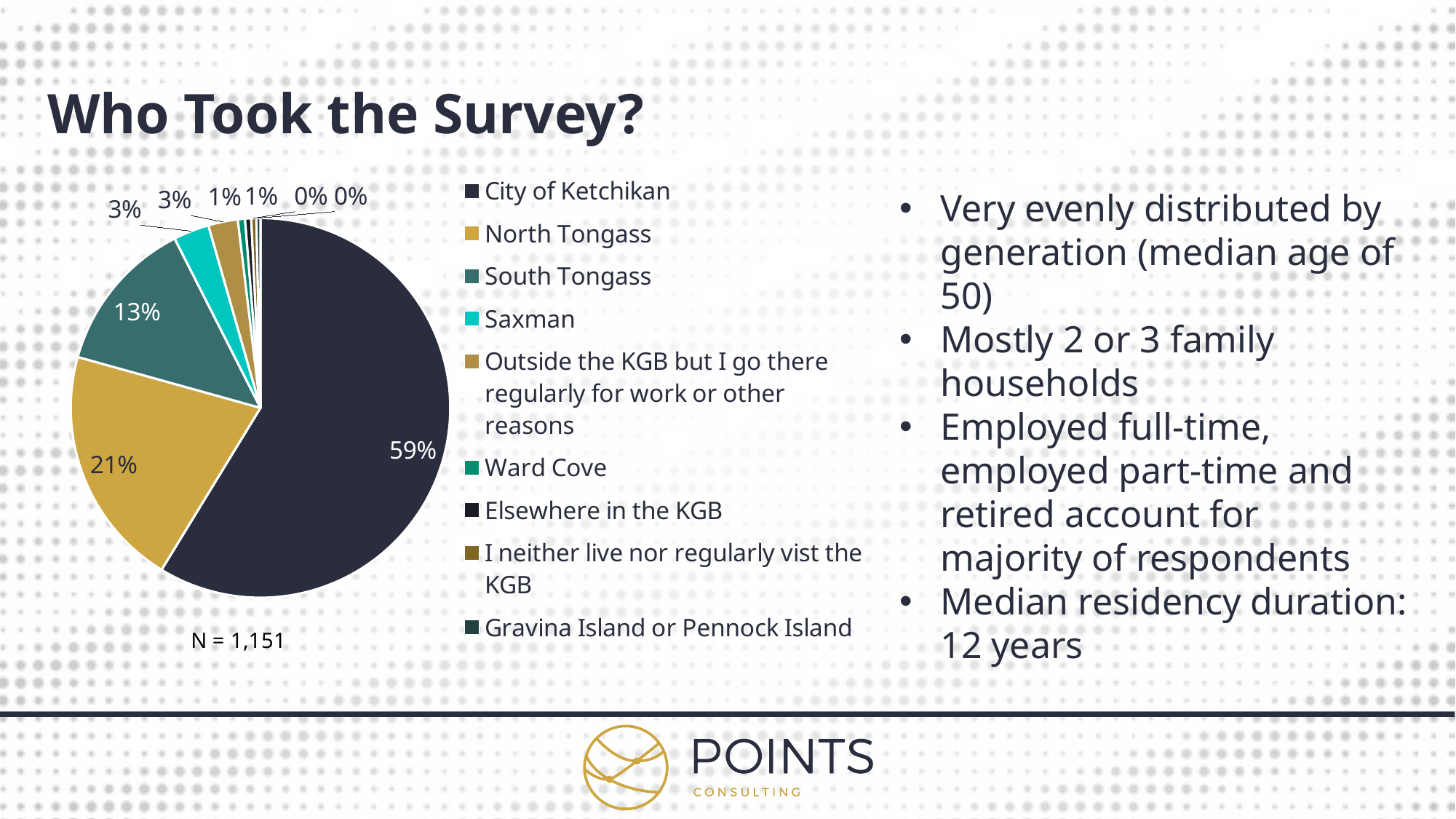
How many categories does the legend list? 9 What share of survey respondents are from the City of Ketchikan? 59% Which is larger, the North Tongass slice or the South Tongass slice? North Tongass What is the title of the slide containing the pie chart? Who Took the Survey? What is the sample size (N) shown below the pie chart? N = 1,151 What is the combined share of the City of Ketchikan and North Tongass slices? 80% What type of chart is shown on the slide? pie chart What share of survey respondents are from North Tongass? 21% What is the difference in percentage points between the City of Ketchikan and North Tongass slices? 38 Which category has the largest slice of the pie? City of Ketchikan What share of survey respondents are from Saxman? 3%